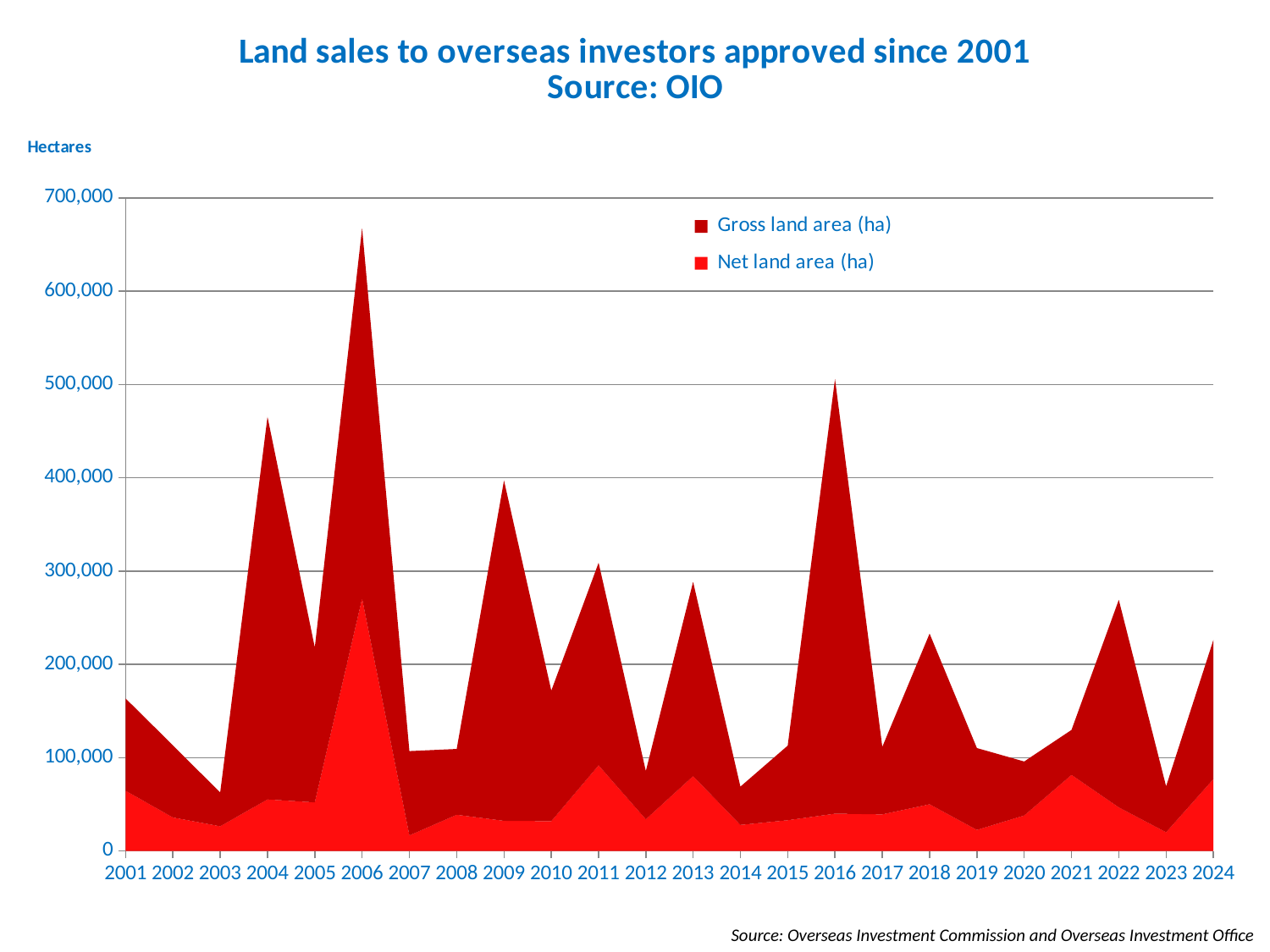
What kind of chart is shown on the slide? Area chart Is the Gross land area (ha) for 2023 greater or less than 100,000? less Which year has the larger Gross land area (ha), 2006 or 2016? 2016 How many series does the legend list? 2 In which year is the Gross land area (ha) highest? 2016 How many years are plotted along the x axis? 24 Does the Net land area (ha) rise or fall from 2021 to 2023? Fall Is the Net land area (ha) for 2006 greater or less than 200,000? greater What is the title of the chart? Land sales to overseas investors approved since 2001 Source: OIO In which year is the Net land area (ha) highest? 2006 Is the Gross land area (ha) for 2006 greater or less than 600,000? less